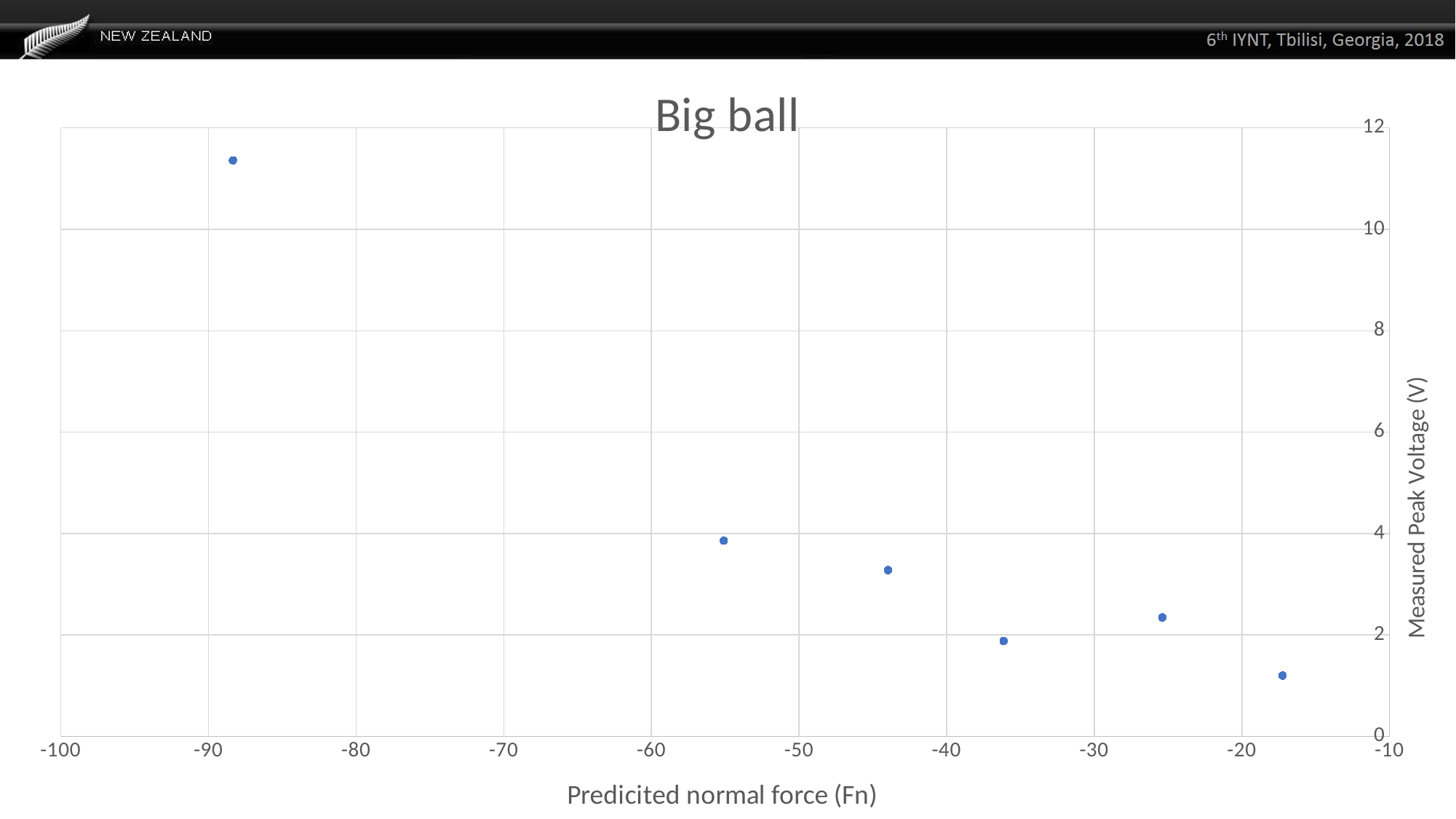
Which point has the lowest measured peak voltage on the chart? the point near -17 Overall, does the measured peak voltage rise or fall as the predicted normal force increases from -100 toward -10? fall Is the measured peak voltage of the point near a predicted normal force of -25 greater or less than 2? greater Which point has the higher measured peak voltage: the one near -55 or the one near -44 on the x axis? the one near -55 What is the label of the vertical axis? Measured Peak Voltage (V) What kind of chart is shown on the slide? scatter chart Is the measured peak voltage of the point near a predicted normal force of -17 greater or less than 2? less Is the measured peak voltage of the point near a predicted normal force of -44 greater or less than 2? greater What is the title of the chart? Big ball Which point has the highest measured peak voltage: the one near -88 or the one near -55 on the x axis? the one near -88 How many data points are plotted on the chart? 6